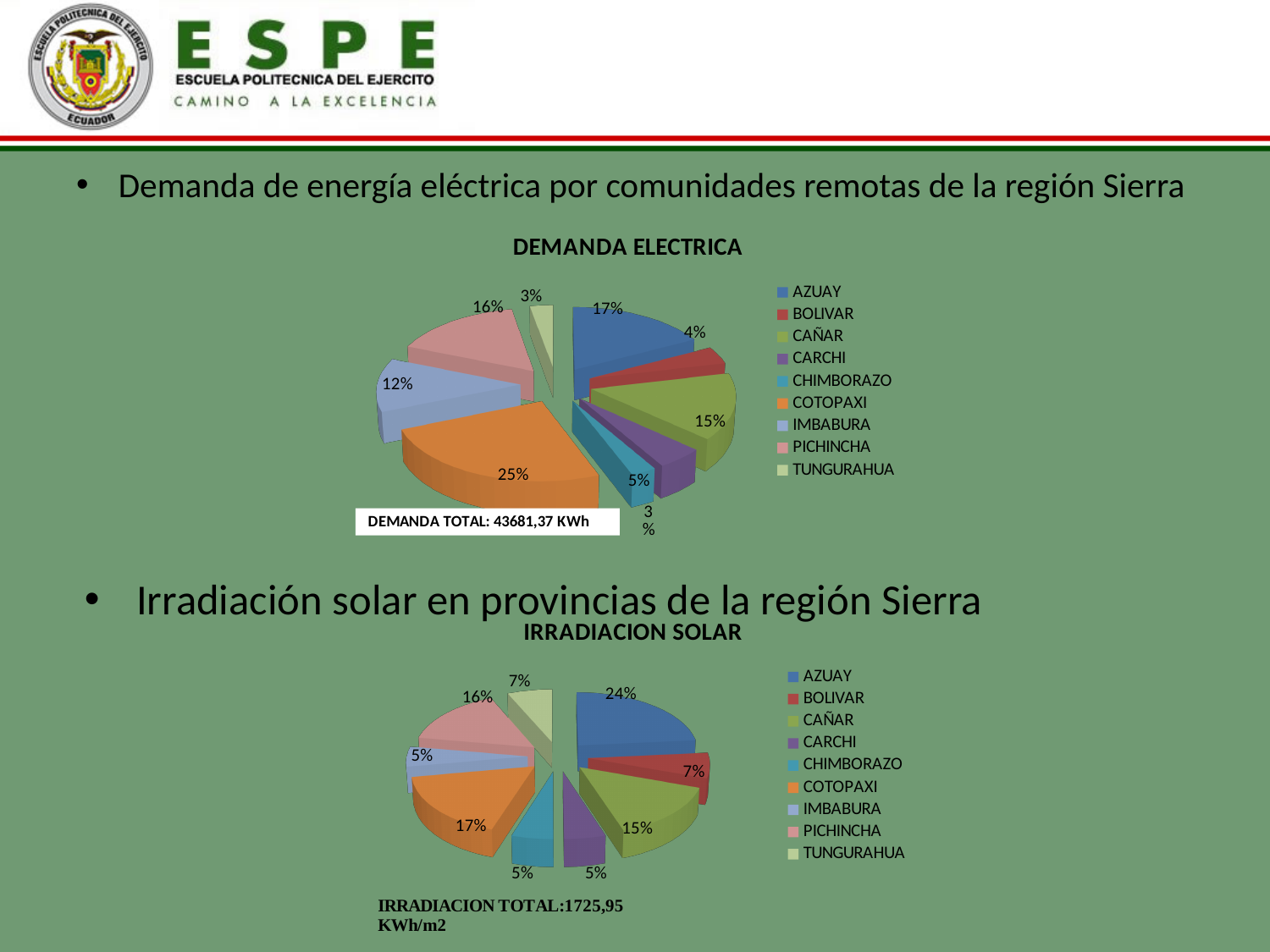
What kind of chart is the IRRADIACION SOLAR chart? Pie chart In the IRRADIACION SOLAR chart, what is the difference between the shares of PICHINCHA and BOLIVAR? 9% How many provinces does the legend of the DEMANDA ELECTRICA chart list? 9 In the DEMANDA ELECTRICA chart, what is the difference between the shares of PICHINCHA and BOLIVAR? 12% In the DEMANDA ELECTRICA chart, which province has the largest share? COTOPAXI In the IRRADIACION SOLAR chart, what share does AZUAY have? 24% In the DEMANDA ELECTRICA chart, which is larger, the share of AZUAY or the share of CAÑAR? AZUAY In the IRRADIACION SOLAR chart, which province has the largest share? AZUAY What total demand is stated below the DEMANDA ELECTRICA chart? 43681,37 KWh In the IRRADIACION SOLAR chart, what is the share for COTOPAXI? 17% In the DEMANDA ELECTRICA chart, what share of the pie does COTOPAXI have? 25% In the DEMANDA ELECTRICA chart, what is the share for IMBABURA? 12%